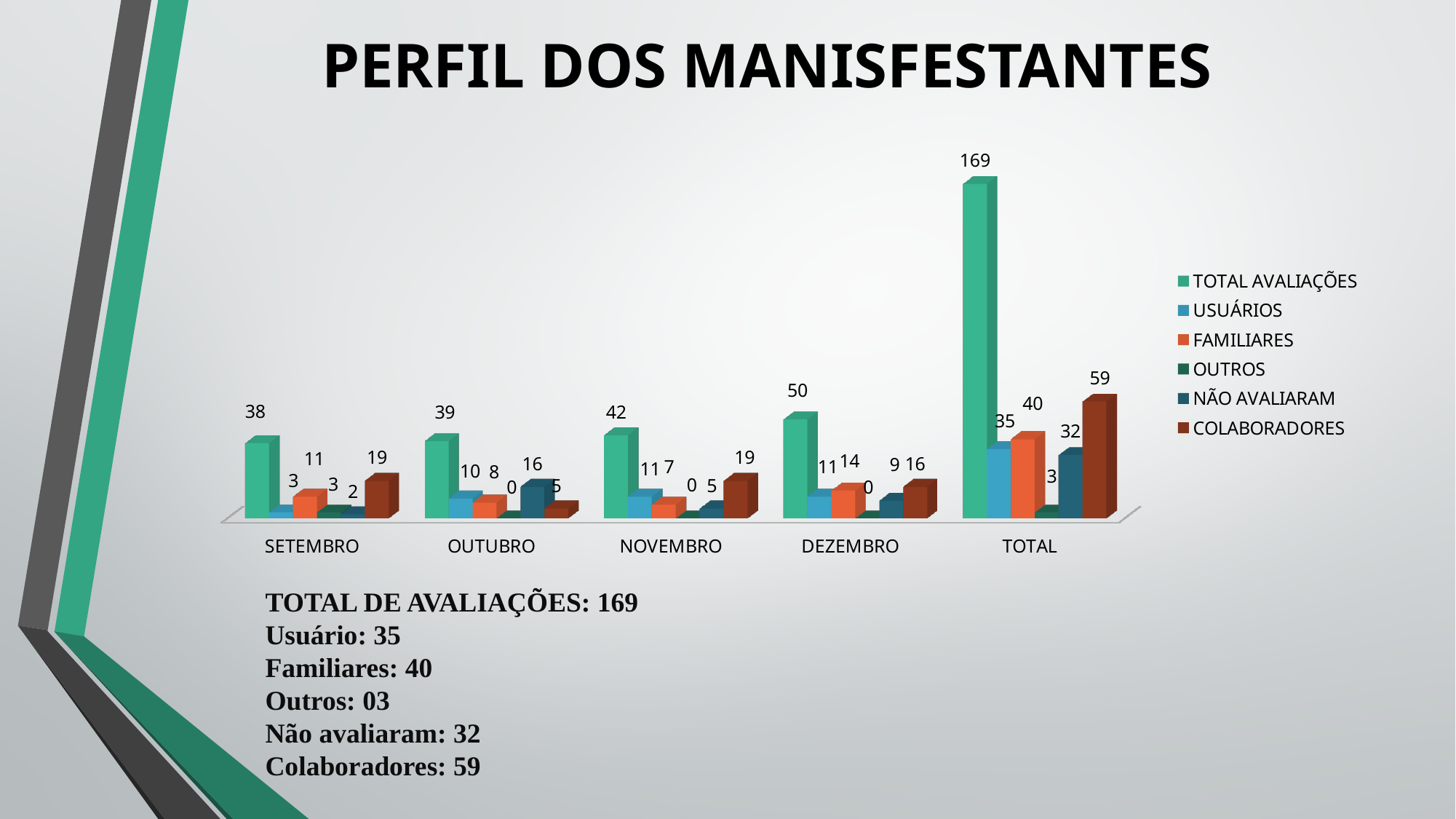
What is the value of NÃO AVALIARAM for OUTUBRO? 16 What is the value of FAMILIARES for the TOTAL category? 40 Which is larger in NOVEMBRO: USUÁRIOS or FAMILIARES? USUÁRIOS Which series has the lowest value in the TOTAL category? OUTROS Do the TOTAL AVALIAÇÕES values rise or fall from SETEMBRO to DEZEMBRO? rise How many categories are shown on the x axis? 5 How many series does the legend list? 6 Which month (excluding TOTAL) has the highest TOTAL AVALIAÇÕES value? DEZEMBRO What is the difference between the TOTAL AVALIAÇÕES values for DEZEMBRO and SETEMBRO? 12 What is the value of TOTAL AVALIAÇÕES for DEZEMBRO? 50 What is the value of COLABORADORES for SETEMBRO? 19 What type of chart is shown on the slide? bar chart